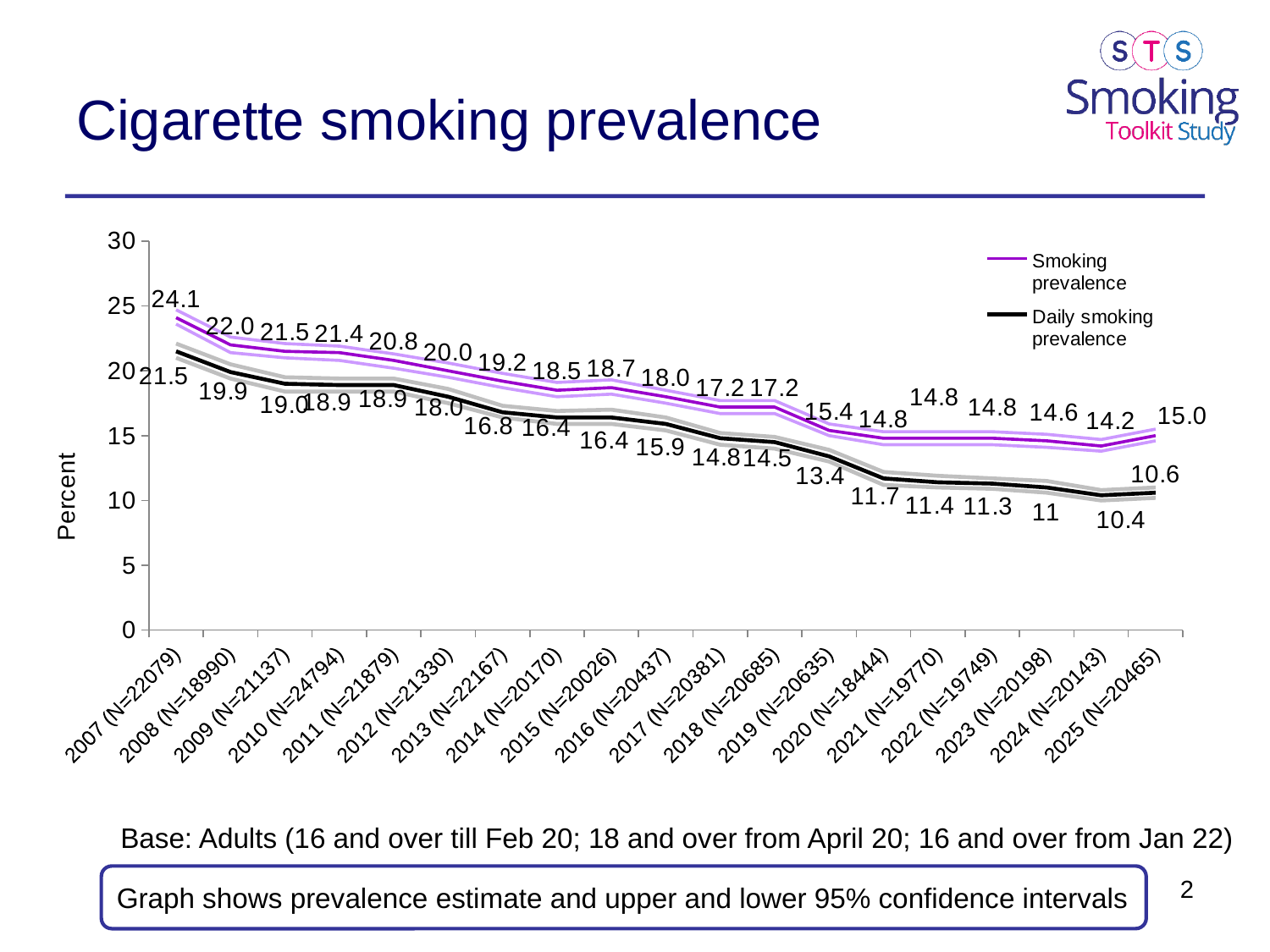
What is the smoking prevalence value for 2007? 24.1 How many years are plotted on the x axis? 19 In which year is smoking prevalence highest? 2007 What kind of chart is shown? Line chart What is the difference between smoking prevalence and daily smoking prevalence in 2007? 2.6 What is the daily smoking prevalence value for 2025? 10.6 In which year is smoking prevalence lowest? 2024 By how much did daily smoking prevalence fall from 2007 to 2025? 10.9 In which year is daily smoking prevalence lowest? 2024 What is the smoking prevalence value for 2019? 15.4 How many series does the legend list? 2 Which year has the higher smoking prevalence, 2024 or 2025? 2025